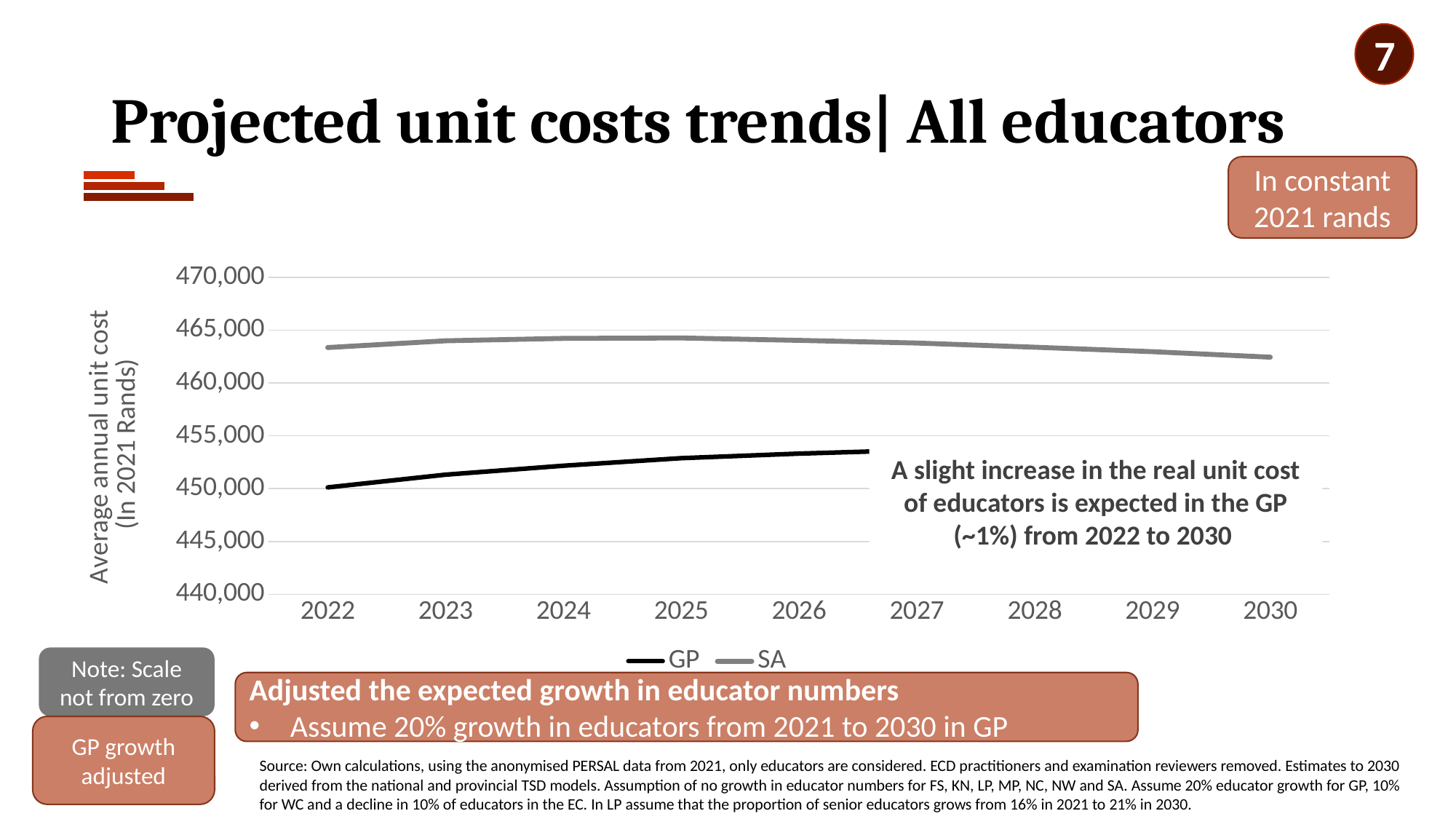
Is the value for SA in 2030 greater or less than 465,000? less What is the label on the y axis of the chart? Average annual unit cost (In 2021 Rands) How many series does the legend list? 2 Does the GP line rise or fall from 2022 to 2026? rise Which series are listed in the legend? GP and SA Is the value for GP in 2026 greater or less than 450,000? greater Is the value for GP in 2022 greater or less than 455,000? less Which series has the higher value in 2022, GP or SA? SA What kind of chart is shown on the slide? line chart How many years are shown on the x axis? 9 Which series has the higher value in 2026, GP or SA? SA